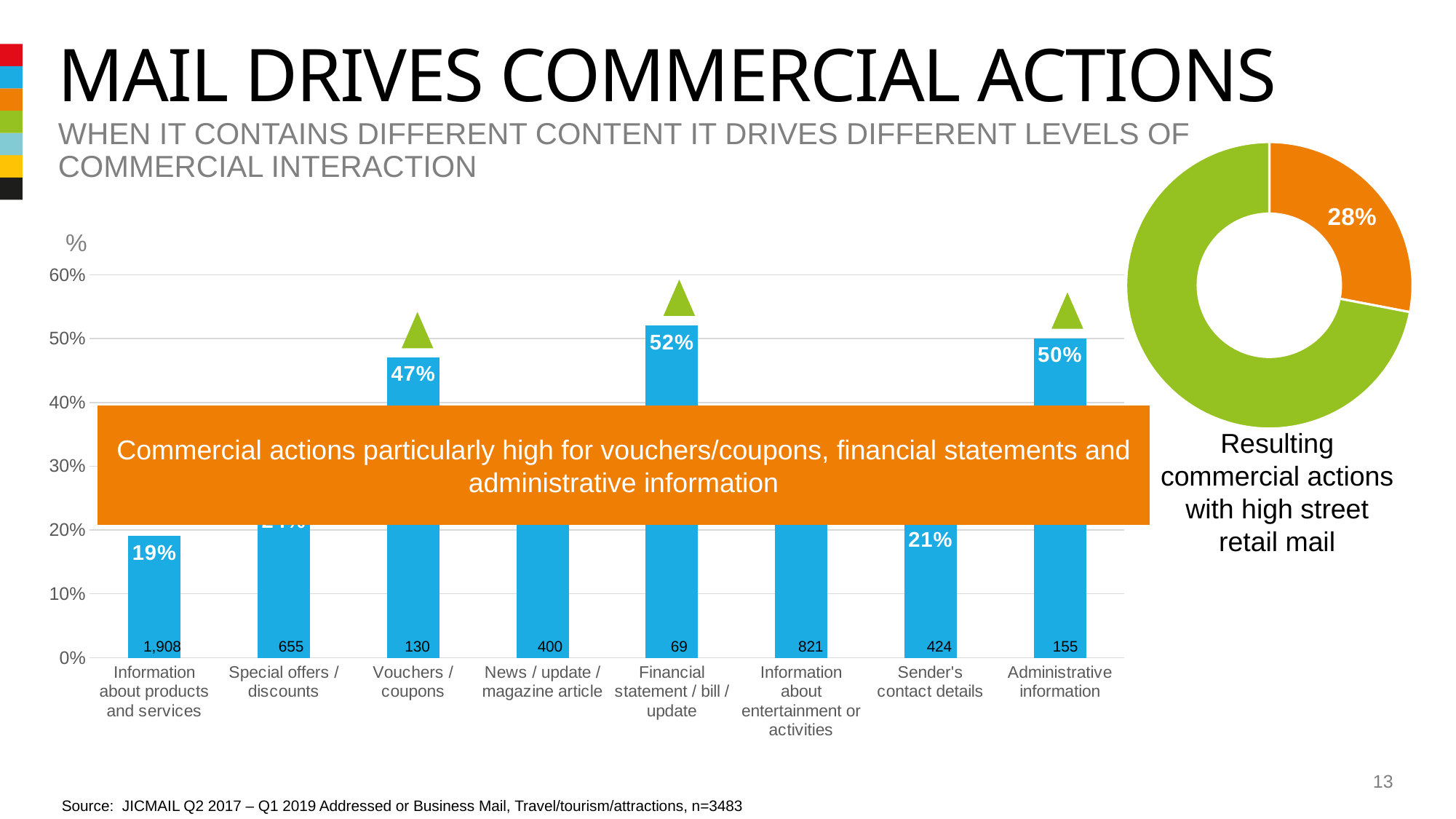
In the bar chart, what is the difference between the values for Financial statement / bill / update and Vouchers / coupons? 5% In the bar chart, is the value for Sender's contact details greater or less than 30%? less How many categories are shown in the bar chart? 8 What kind of chart is the chart on the left of the slide? bar chart In the bar chart, what is the value for Information about products and services? 19% What is the sample size printed at the base of the Information about products and services bar? 1,908 In the bar chart, which is larger: the value for Administrative information or the value for Sender's contact details? Administrative information In the bar chart, what is the value for Administrative information? 50% In the donut chart on the right, what percentage is shown for the orange slice? 28% In the bar chart, which category has the highest value? Financial statement / bill / update In the bar chart, what is the value for Vouchers / coupons? 47% In the bar chart, what is the value for Financial statement / bill / update? 52%